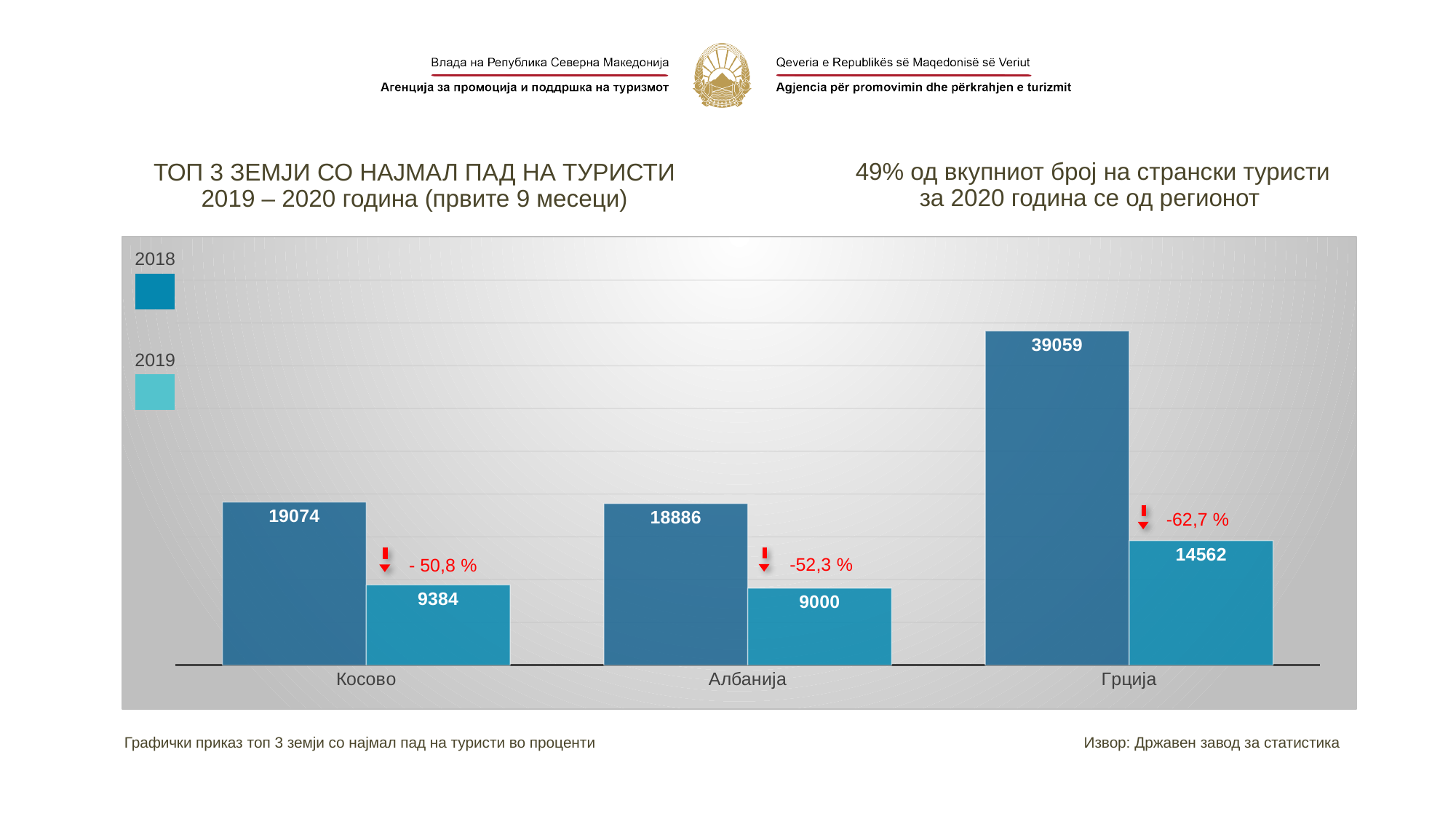
How many countries are shown on the chart? 3 What kind of chart is shown on the slide? bar chart What is the value of the 2019 series for Албанија? 9000 What is the difference between the 2018 and 2019 values for Косово? 9690 What is the value of the 2019 series for Грција? 14562 Which country has the lowest value in the 2019 series? Албанија How many series does the legend list? 2 What is the value of the 2018 series for Косово? 19074 Which is larger: the 2019 value for Грција or the 2018 value for Косово? 2018 value for Косово What is the difference between the 2018 values for Грција and Албанија? 20173 Which country has the highest value in the 2018 series? Грција What percentage change is shown next to the bars for Албанија? -52,3 %